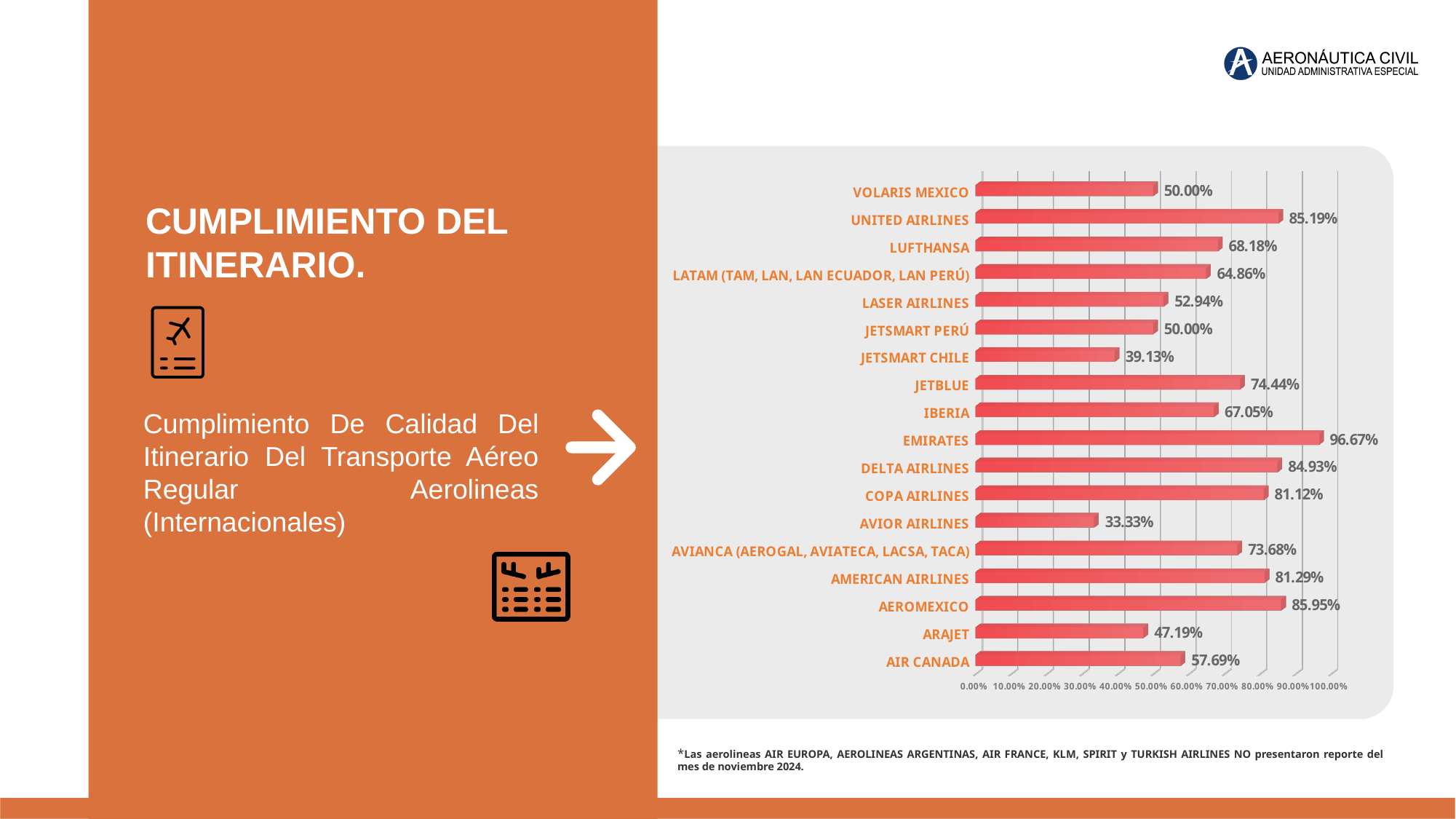
Which airline has the highest value? EMIRATES Which airline has the lowest value? AVIOR AIRLINES What is the difference between the values for EMIRATES and AVIOR AIRLINES? 63.34% How many airlines are shown in the chart? 18 What is the value for AIR CANADA? 57.69% What is the value for EMIRATES? 96.67% What is the value for JETSMART CHILE? 39.13% What is the value for LATAM (TAM, LAN, LAN ECUADOR, LAN PERÚ)? 64.86% What is the highest value shown on the x axis? 100.00% Which is larger, the value for COPA AIRLINES or the value for JETBLUE? COPA AIRLINES What kind of chart is shown on the slide? Bar chart What is the difference between the values for LUFTHANSA and IBERIA? 1.13%